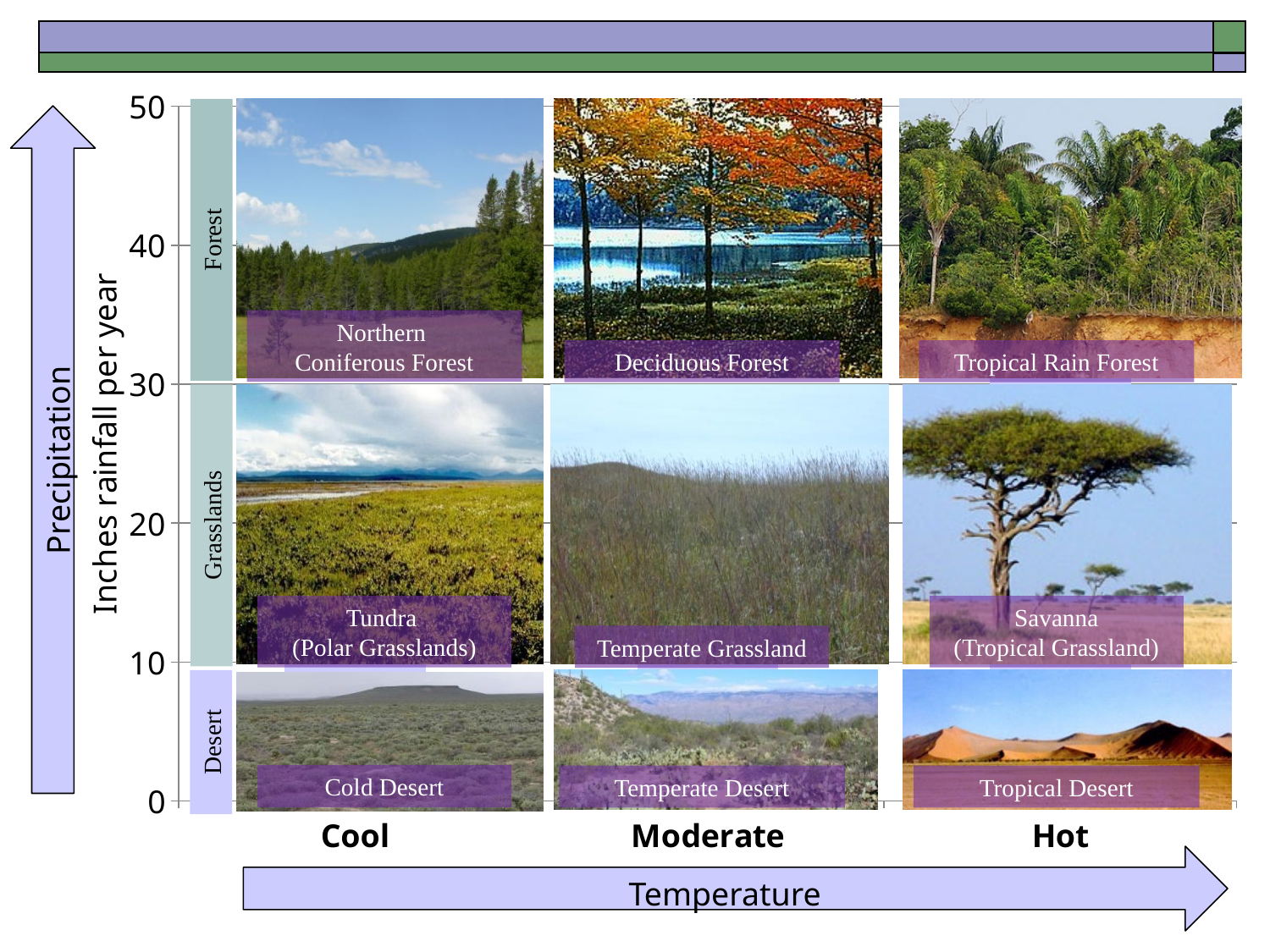
How many precipitation bands are labelled along the y axis? 3 How many biomes are shown in the grid? 9 Is the Desert precipitation band above or below 10 inches of rainfall per year? below Which biome occupies the cell for Cool temperature and the Grasslands precipitation band? Tundra (Polar Grasslands) Which biome occupies the cell for Cool temperature and the Forest precipitation band? Northern Coniferous Forest Which biome occupies the cell for Hot temperature and the Forest precipitation band? Tropical Rain Forest What is the unit given for the precipitation axis? Inches rainfall per year Which biome occupies the cell for Moderate temperature and the Desert precipitation band? Temperate Desert How many temperature categories are labelled along the x axis? 3 What are the three temperature categories labelled along the x axis, from left to right? Cool, Moderate, Hot Is the Forest precipitation band above or below 30 inches of rainfall per year? above Which biome occupies the cell for Hot temperature and the Grasslands precipitation band? Savanna (Tropical Grassland)